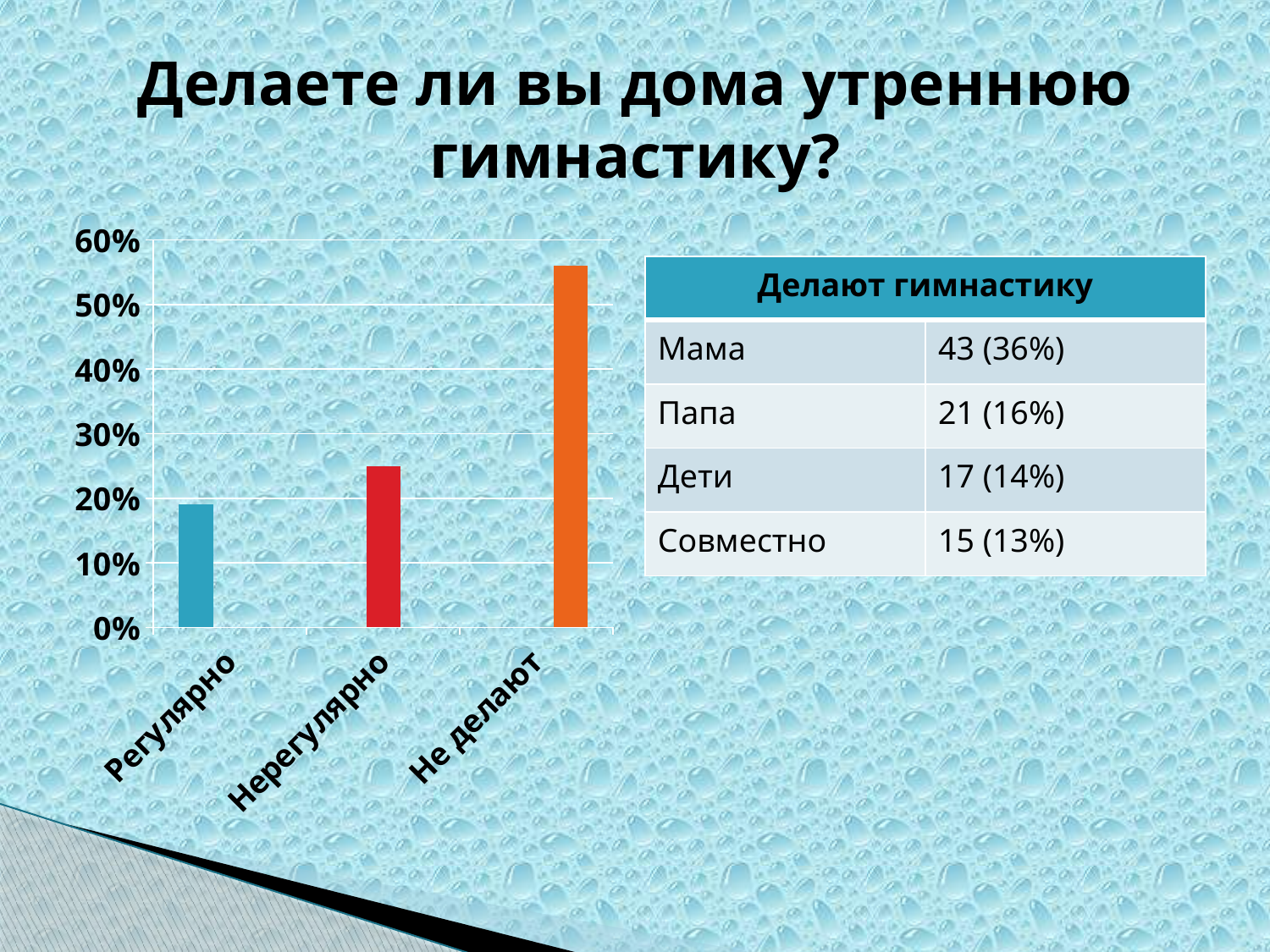
Do the bar values rise or fall from left to right along the x axis? rise Is the value for Не делают greater or less than 50%? greater What kind of chart is shown on the slide? bar chart Is the value for Нерегулярно greater or less than 30%? less How many categories are shown on the x axis of the chart? 3 Which category has the lowest bar in the chart? Регулярно Which is larger, the value for Нерегулярно or the value for Не делают? Не делают What colour is the bar for Не делают? orange Is the value for Регулярно greater or less than 10%? greater Which is larger, the value for Регулярно or the value for Нерегулярно? Нерегулярно What is the highest value shown on the chart's vertical axis? 60% Which category has the highest bar in the chart? Не делают